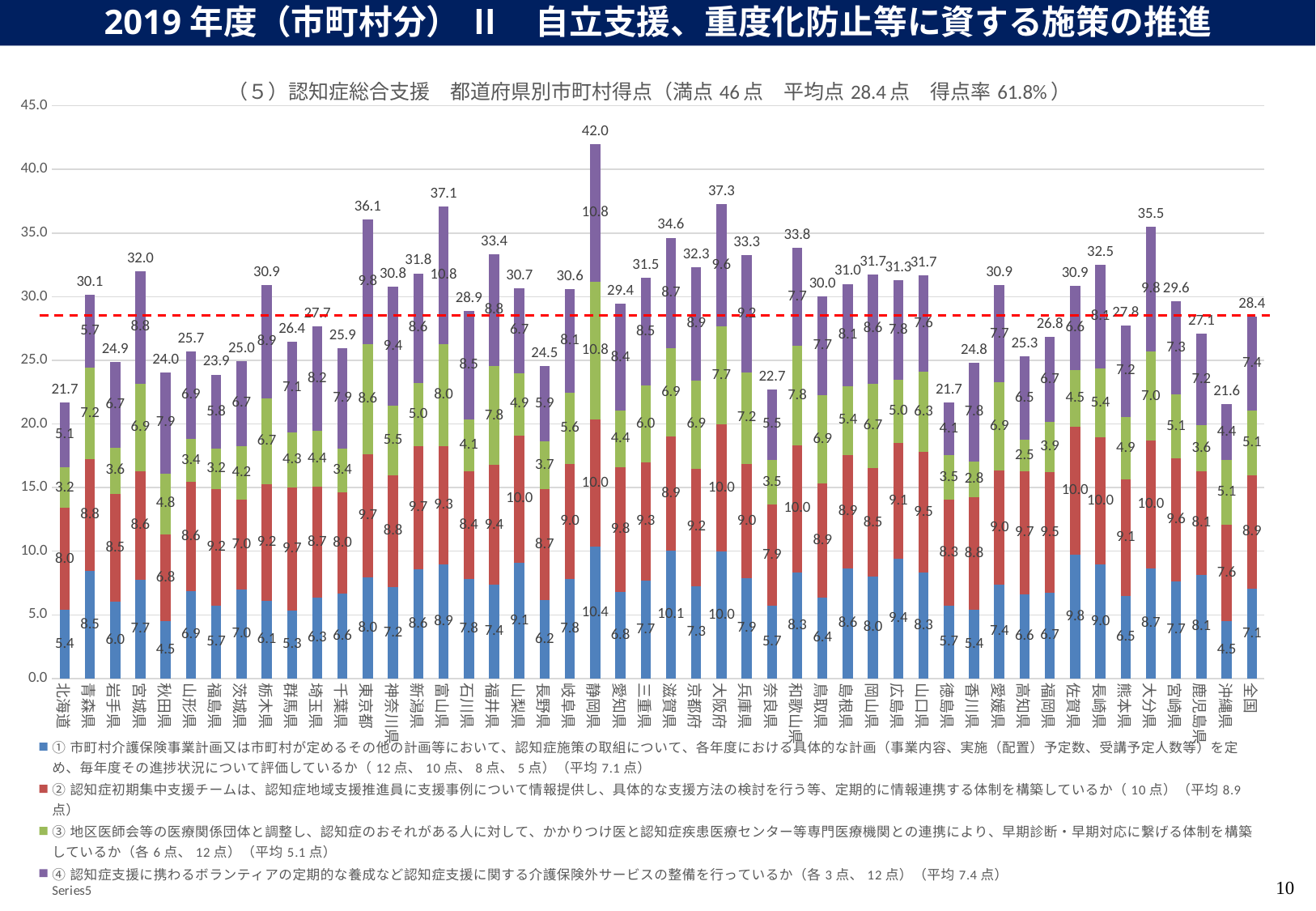
Is the total score for 沖縄県 greater or less than 25.0? less What is the total score shown for 東京都? 36.1 Which prefecture has the highest total score in the chart? 静岡県 What is the total score shown for 静岡県? 42.0 Which prefecture has the lowest total score in the chart? 沖縄県 How many bars are plotted in the chart (including 全国)? 48 What value does the red dashed horizontal line in the chart mark? 28.4 (the average score) What is the difference between the total score of 静岡県 and the 全国 total? 13.6 What kind of chart is shown on the slide? Stacked bar chart Which has a higher total score, 東京都 or 大阪府? 大阪府 What is the value of the blue (①) segment for 静岡県? 10.4 What is the total score shown for 全国 (the rightmost bar)? 28.4